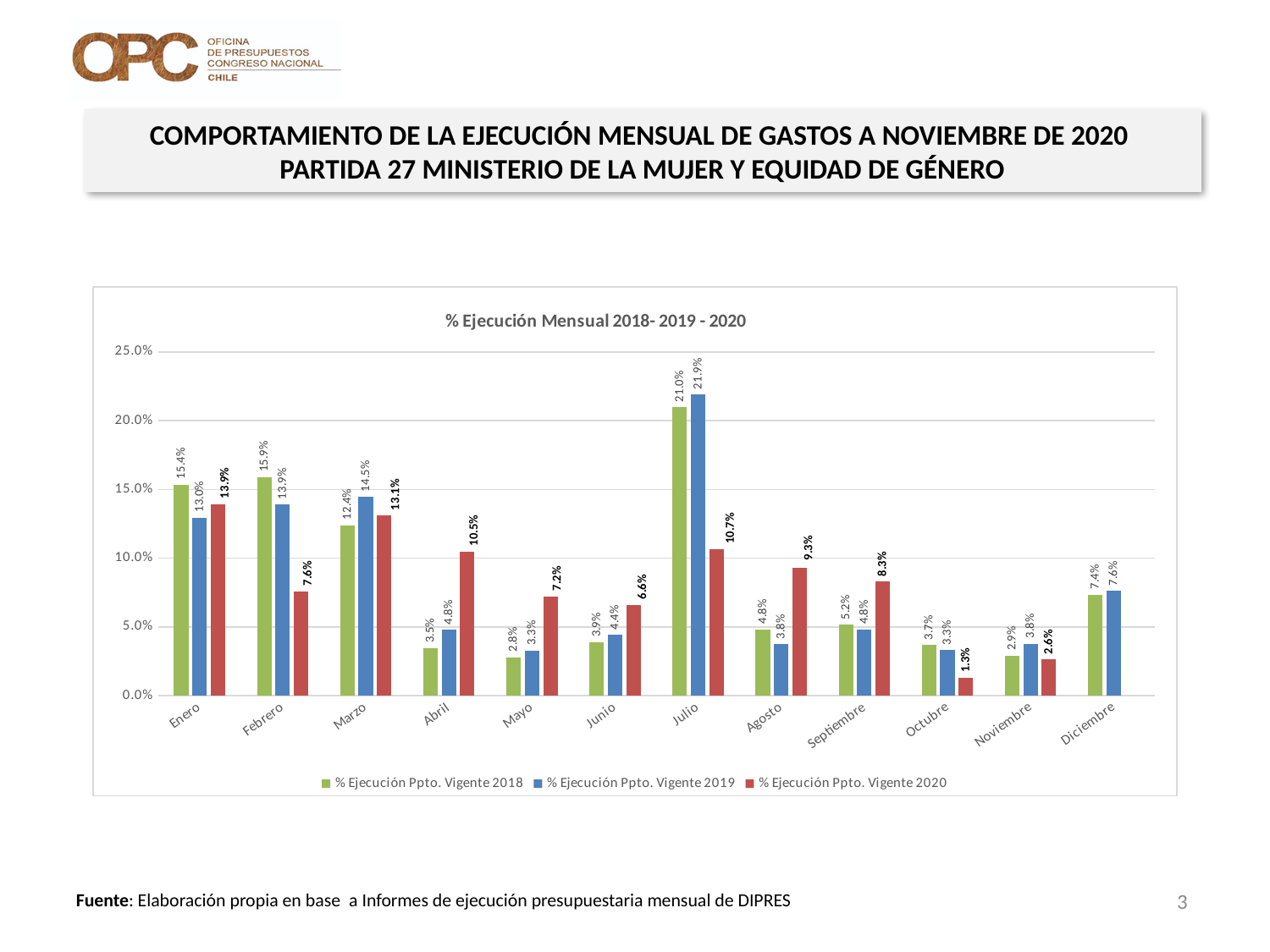
What is the title of the chart? % Ejecución Mensual 2018- 2019 - 2020 What is the difference between the 2019 and 2018 values in Julio? 0.9% How many months are shown on the x axis? 12 Which month has the highest value for % Ejecución Ppto. Vigente 2020? Enero What is the value for % Ejecución Ppto. Vigente 2020 in Abril? 10.5% How many series does the legend list? 3 What is the value for % Ejecución Ppto. Vigente 2019 in Julio? 21.9% Which is larger in Marzo: the 2018 value or the 2019 value? 2019 Does the 2020 series rise or fall from Agosto to Octubre? Fall What is the value for % Ejecución Ppto. Vigente 2018 in Febrero? 15.9% What kind of chart is shown on the slide? Bar chart Which month has the lowest value for % Ejecución Ppto. Vigente 2020? Octubre